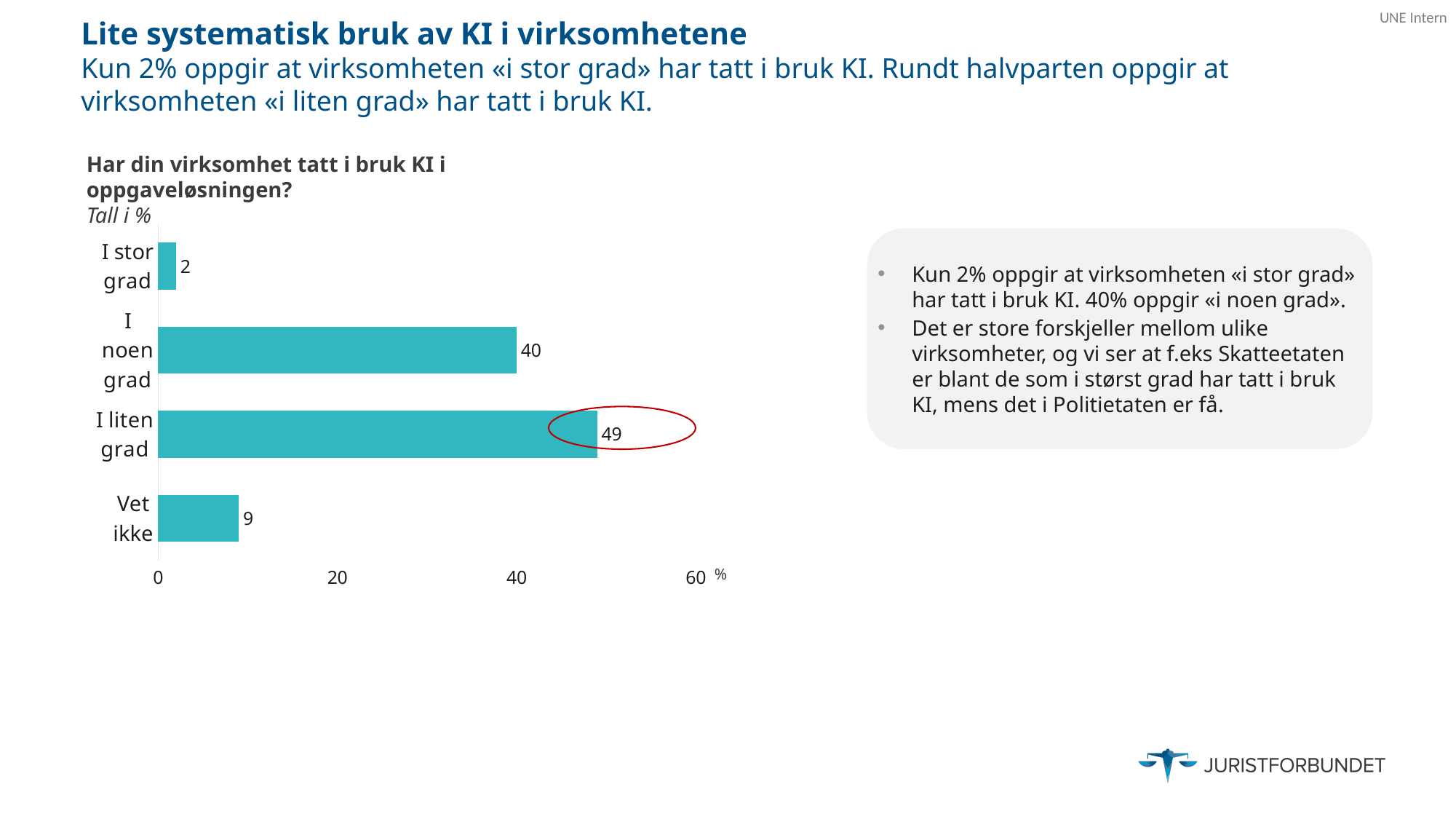
What is the value for "I noen grad"? 40 What is the value for "I liten grad"? 49 What is the value for "Vet ikke"? 9 Which is larger, the value for "Vet ikke" or the value for "I stor grad"? Vet ikke What is the difference between the values for "I liten grad" and "I noen grad"? 9 Which category has the highest value? I liten grad How many categories are shown in the chart? 4 Is the value for "I liten grad" greater or less than 40? greater Which category has the lowest value? I stor grad What is the value for "I stor grad"? 2 What is the title of the chart? Har din virksomhet tatt i bruk KI i oppgaveløsningen? What kind of chart is shown on the slide? Bar chart